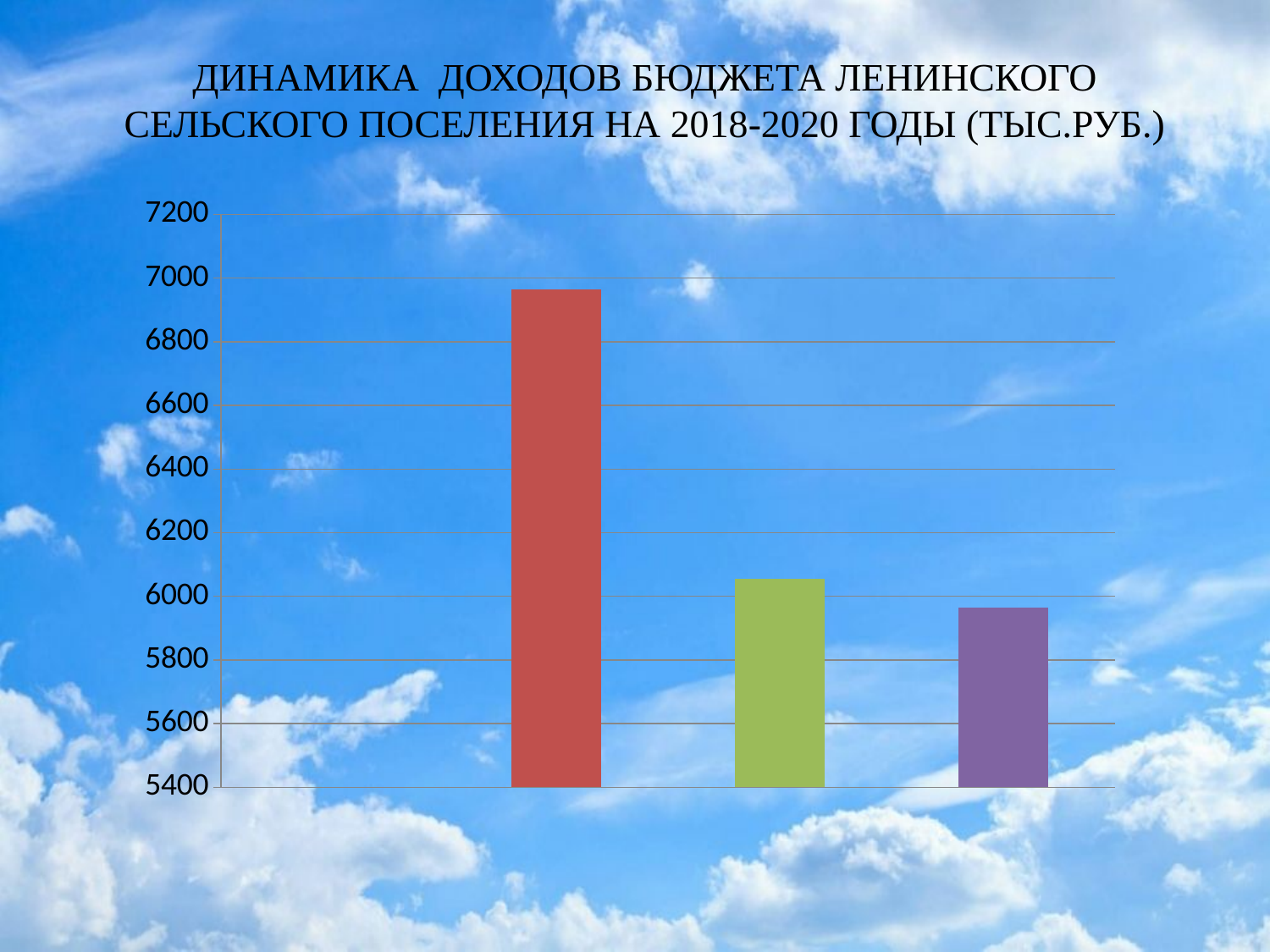
Is the value of the red bar greater or less than 6800? greater Which bar is the shortest in the chart? the purple bar (third from the left) Which bar is the tallest in the chart? the red bar (first from the left) Which is larger, the red bar or the green bar? the red bar Which is larger, the green bar or the purple bar? the green bar Is the value of the green bar greater or less than 6200? less What is the highest value shown on the vertical axis of the chart? 7200 How many bars are plotted in the chart? 3 Is the value of the purple bar greater or less than 6200? less What kind of chart is shown on the slide? bar chart Do the bar values rise or fall from left to right across the chart? fall What unit of measurement is given in the slide title for the budget revenues? тыс.руб.